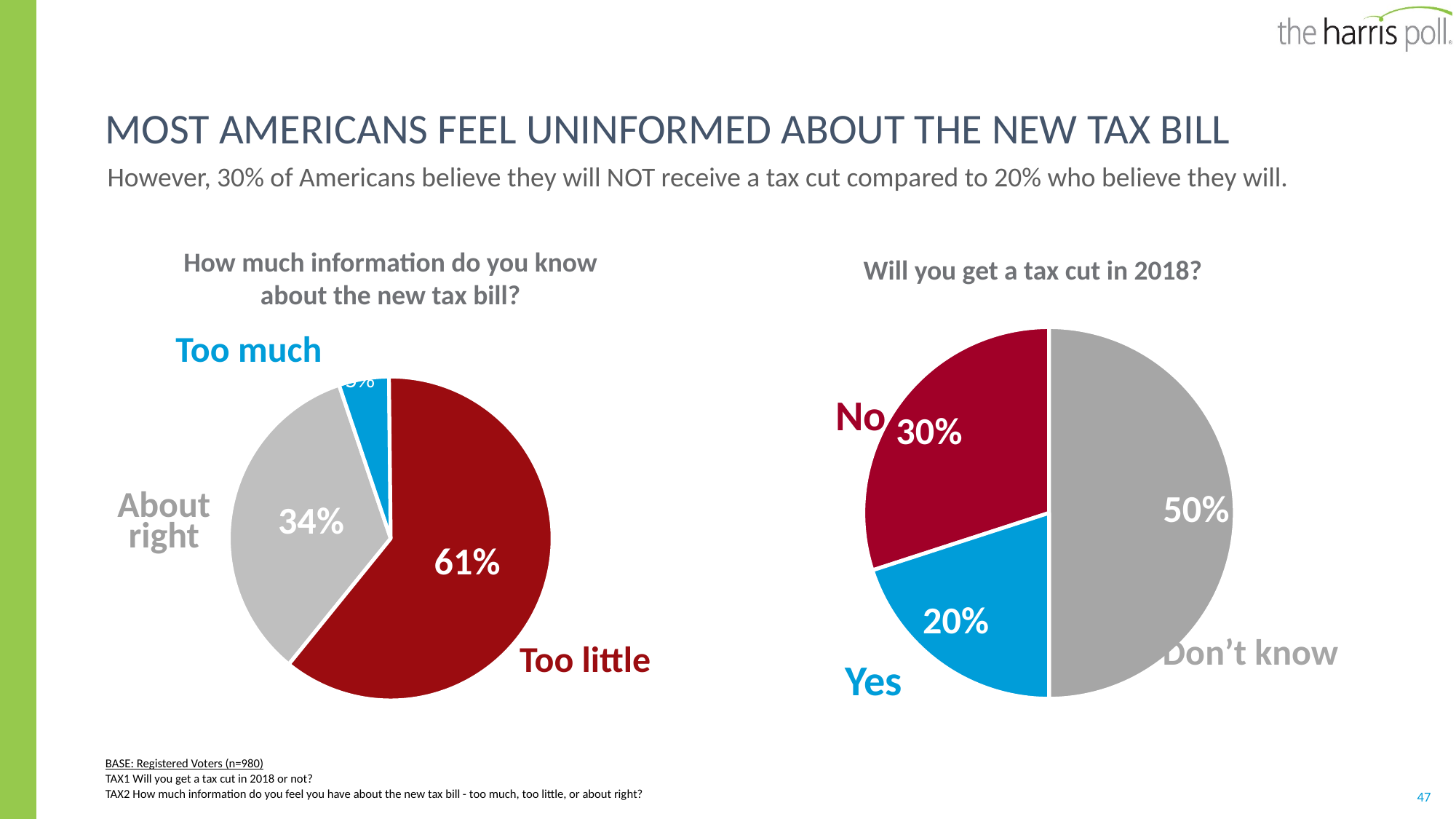
In the chart titled 'How much information do you know about the new tax bill?', which response has the smallest share? Too much In the chart titled 'Will you get a tax cut in 2018?', which response has the smallest share? Yes In the chart titled 'How much information do you know about the new tax bill?', which response has the largest share? Too little In the chart titled 'Will you get a tax cut in 2018?', what is the difference in percentage points between 'No' and 'Yes'? 10 percentage points In the chart titled 'Will you get a tax cut in 2018?', what percentage of respondents said 'Don't know'? 50% What type of chart is used for 'Will you get a tax cut in 2018?'? Pie chart In the chart titled 'How much information do you know about the new tax bill?', what percentage of respondents said 'About right'? 34% In the chart titled 'Will you get a tax cut in 2018?', what percentage of respondents said 'No'? 30% In the chart titled 'How much information do you know about the new tax bill?', what percentage of respondents said 'Too little'? 61% In the chart titled 'Will you get a tax cut in 2018?', which response has the largest share? Don't know In the chart titled 'Will you get a tax cut in 2018?', what percentage of respondents said 'Yes'? 20% In the chart titled 'How much information do you know about the new tax bill?', what is the difference in percentage points between 'Too little' and 'About right'? 27 percentage points